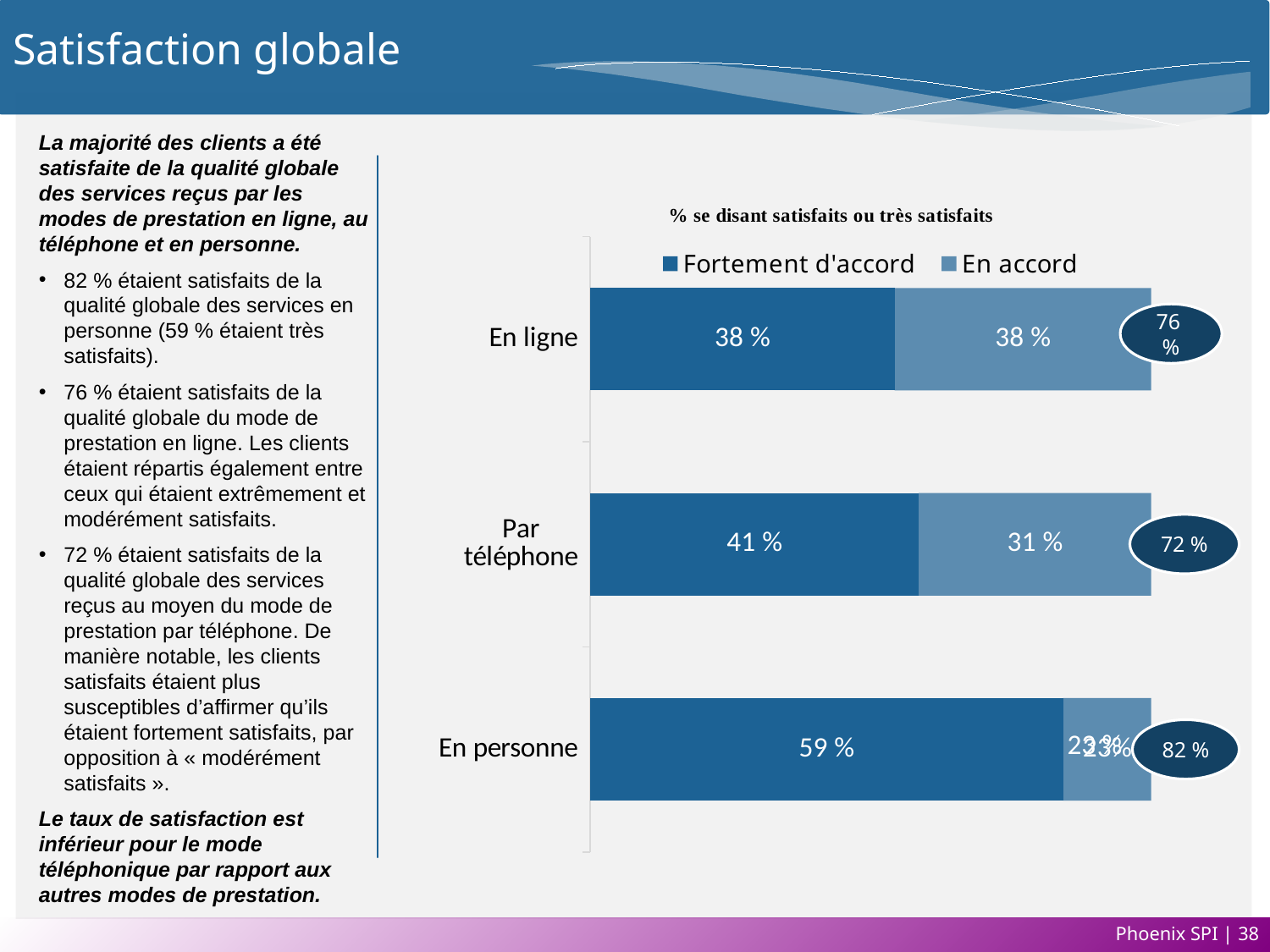
What is the 'Fortement d'accord' value for 'En personne'? 59 % How many categories are shown on the chart? 3 Which is larger: the 'En accord' value for 'En ligne' or for 'Par téléphone'? En ligne What is the 'Fortement d'accord' value for 'En ligne'? 38 % Which category has the highest 'Fortement d'accord' value? En personne What is the title of the chart? % se disant satisfaits ou très satisfaits What is the 'En accord' value for 'Par téléphone'? 31 % How many series does the chart legend list? 2 Which category has the lowest total satisfaction value? Par téléphone What is the total satisfaction value shown for 'Par téléphone'? 72 % What type of chart is shown on the slide? Stacked bar chart What is the difference between the 'Fortement d'accord' values for 'Par téléphone' and 'En ligne'? 3 %